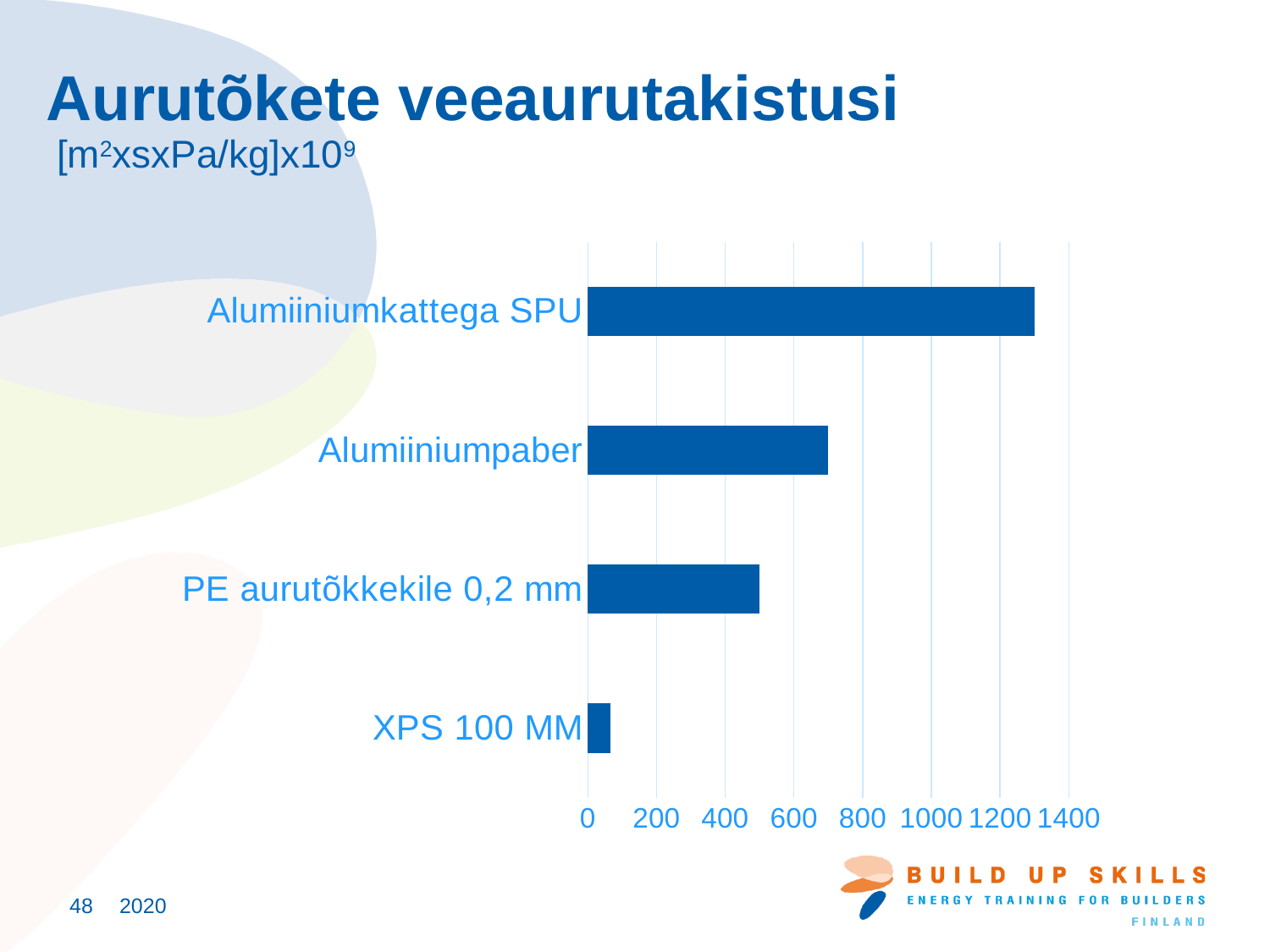
Which is larger, the value for XPS 100 MM or the value for Alumiiniumkattega SPU? Alumiiniumkattega SPU What kind of chart is shown on the slide? bar chart Which category has the lowest value? XPS 100 MM Is the value for PE aurutõkkekile 0,2 mm greater or less than 600? less Is the value for Alumiiniumkattega SPU greater or less than 1200? greater What is the title of the chart on the slide? Aurutõkete veeaurutakistusi What is the highest value shown on the horizontal axis? 1400 Which category has the highest value? Alumiiniumkattega SPU Which is larger, the value for Alumiiniumpaber or the value for PE aurutõkkekile 0,2 mm? Alumiiniumpaber Is the value for XPS 100 MM greater or less than 200? less How many categories are plotted in the chart? 4